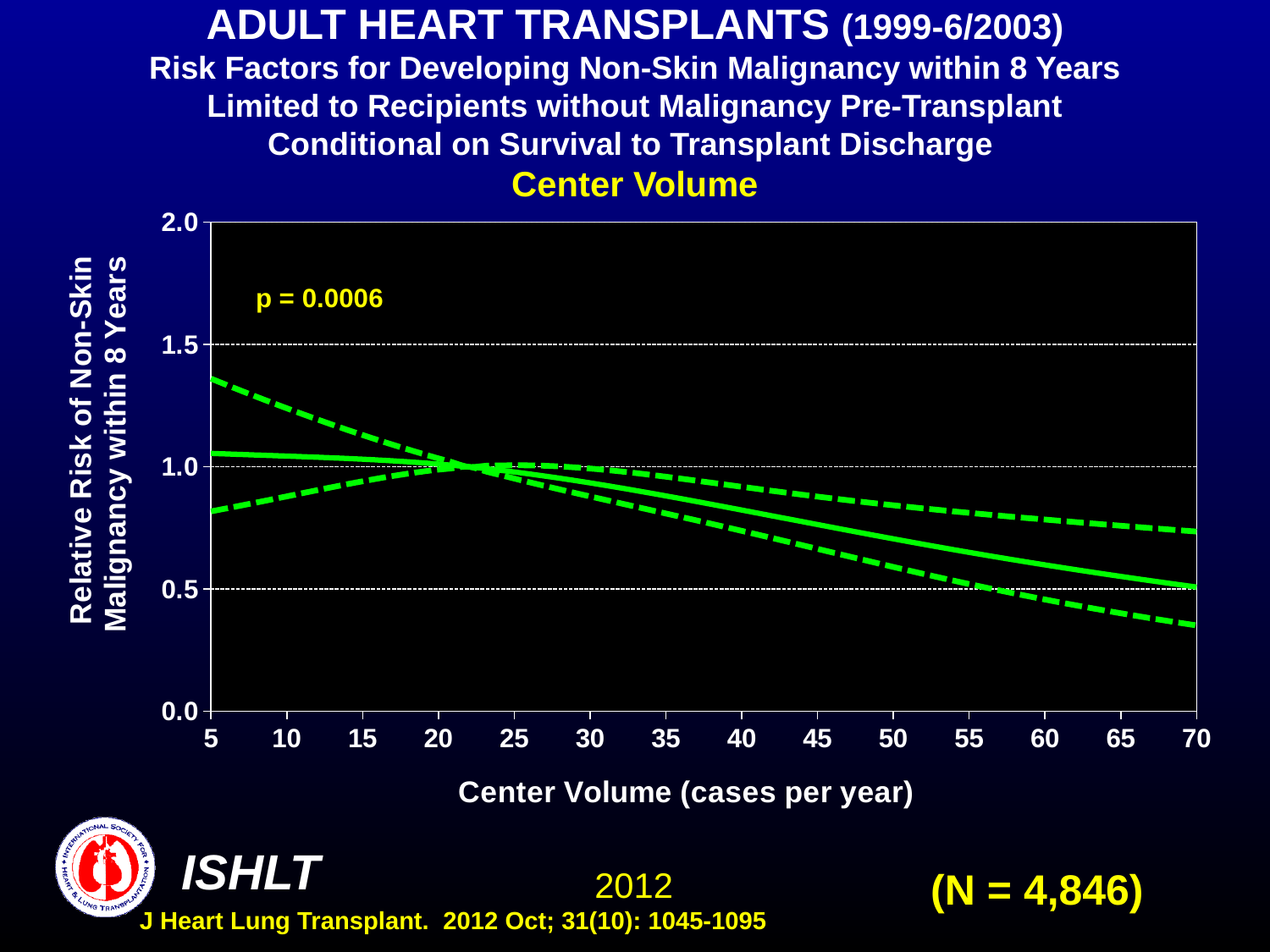
Is the upper dashed line at a center volume of 70 cases per year greater or less than 0.5? greater Does the solid line for relative risk rise or fall as center volume increases from 5 to 70 cases per year? fall What kind of chart is shown on the slide? line chart Is the lower dashed line at a center volume of 70 cases per year greater or less than 0.5? less How many lines are plotted on the chart? 3 Is the relative risk on the solid line at a center volume of 40 cases per year greater or less than 1.0? less What is the N shown on the slide? N = 4,846 What p-value is shown on the chart? p = 0.0006